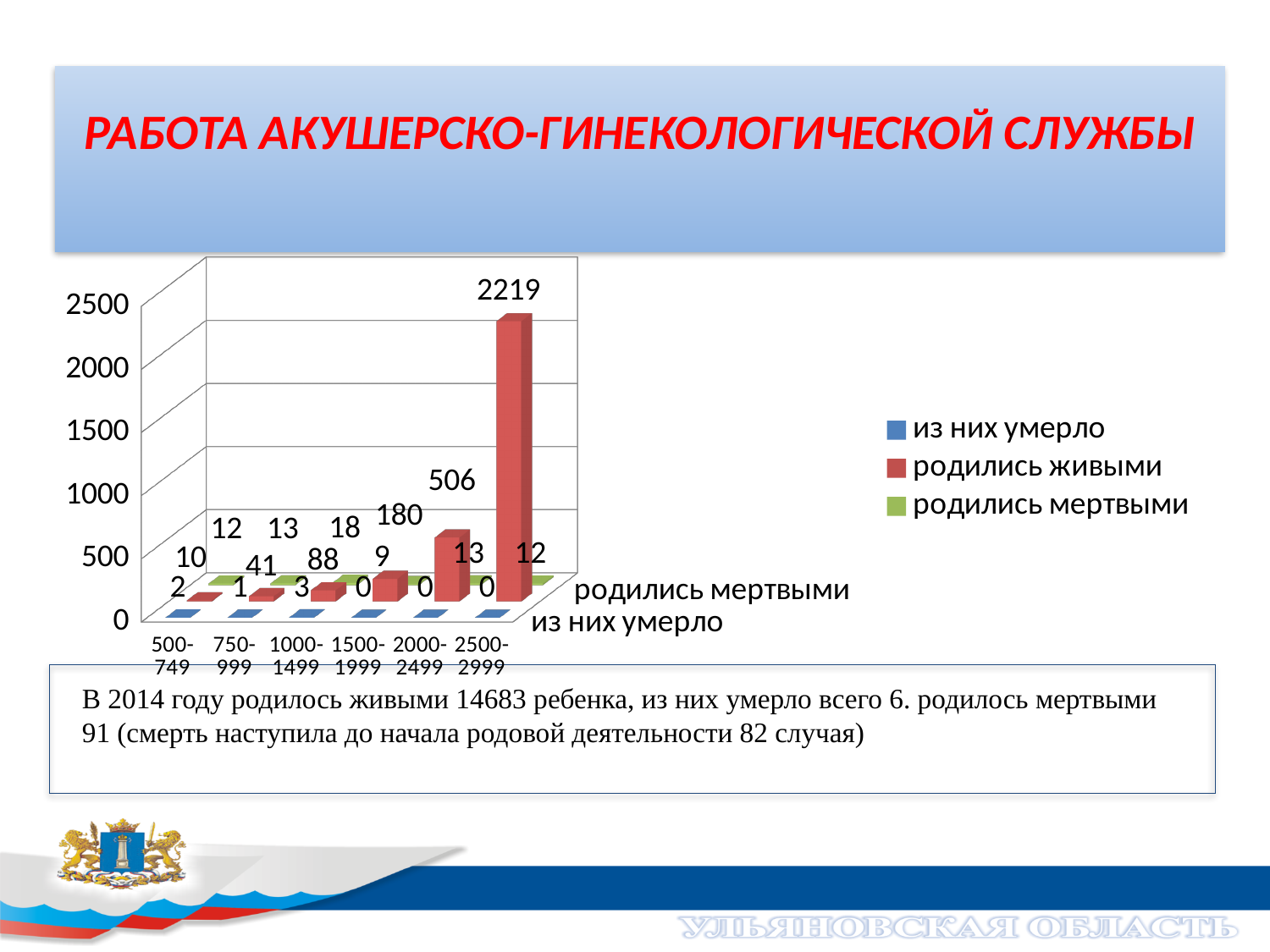
What is the value of из них умерло for the 1000-1499 category? 3 What is the value of родились мертвыми for the 1000-1499 category? 18 Do the values for родились живыми rise or fall from 500-749 to 2500-2999? rise What is the difference between родились живыми for 2500-2999 and for 2000-2499? 1713 How many series does the legend list? 3 For родились живыми, which category has the larger value: 1000-1499 or 1500-1999? 1500-1999 Which category has the highest value for родились живыми? 2500-2999 Which category has the lowest value for родились живыми? 500-749 What is the value of родились живыми for the 2000-2499 category? 506 What is the value of родились живыми for the 2500-2999 category? 2219 How many weight categories are shown on the x axis? 6 What kind of chart is shown on the slide? bar chart